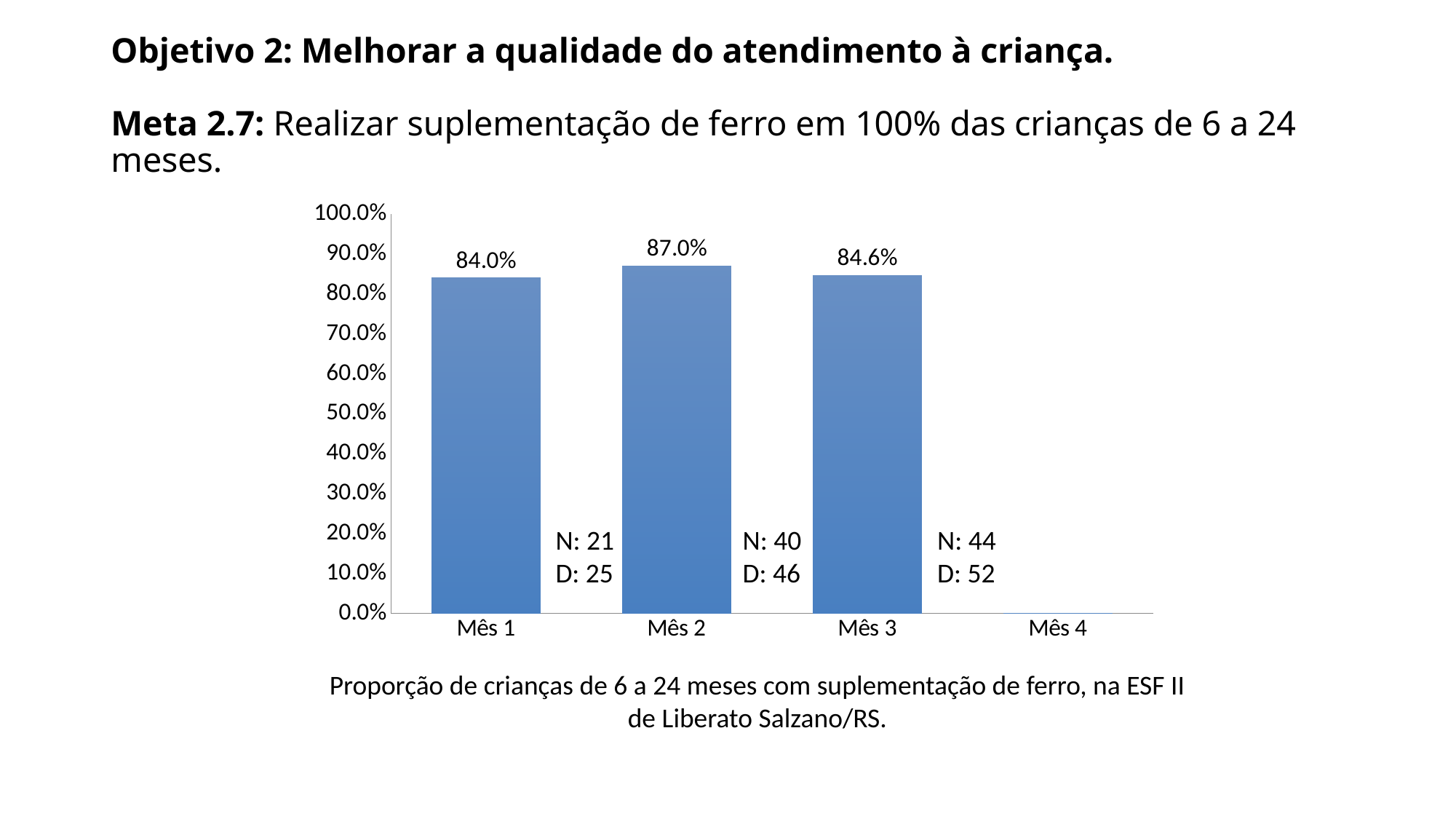
Does the value rise or fall from Mês 1 to Mês 2? Rise Which is larger, the value for Mês 3 or the value for Mês 1? Mês 3 Is the value for Mês 1 greater or less than 80.0%? greater What is the value for Mês 1? 84.0% What is the difference between the values for Mês 2 and Mês 1? 3.0% What is the difference between the values for Mês 2 and Mês 3? 2.4% What is the value for Mês 3? 84.6% What kind of chart is shown on the slide? Bar chart How many month categories are shown on the x axis? 4 Which month has the highest proportion? Mês 2 What is the value for Mês 2? 87.0% What is the denominator (D) shown for Mês 3? 52